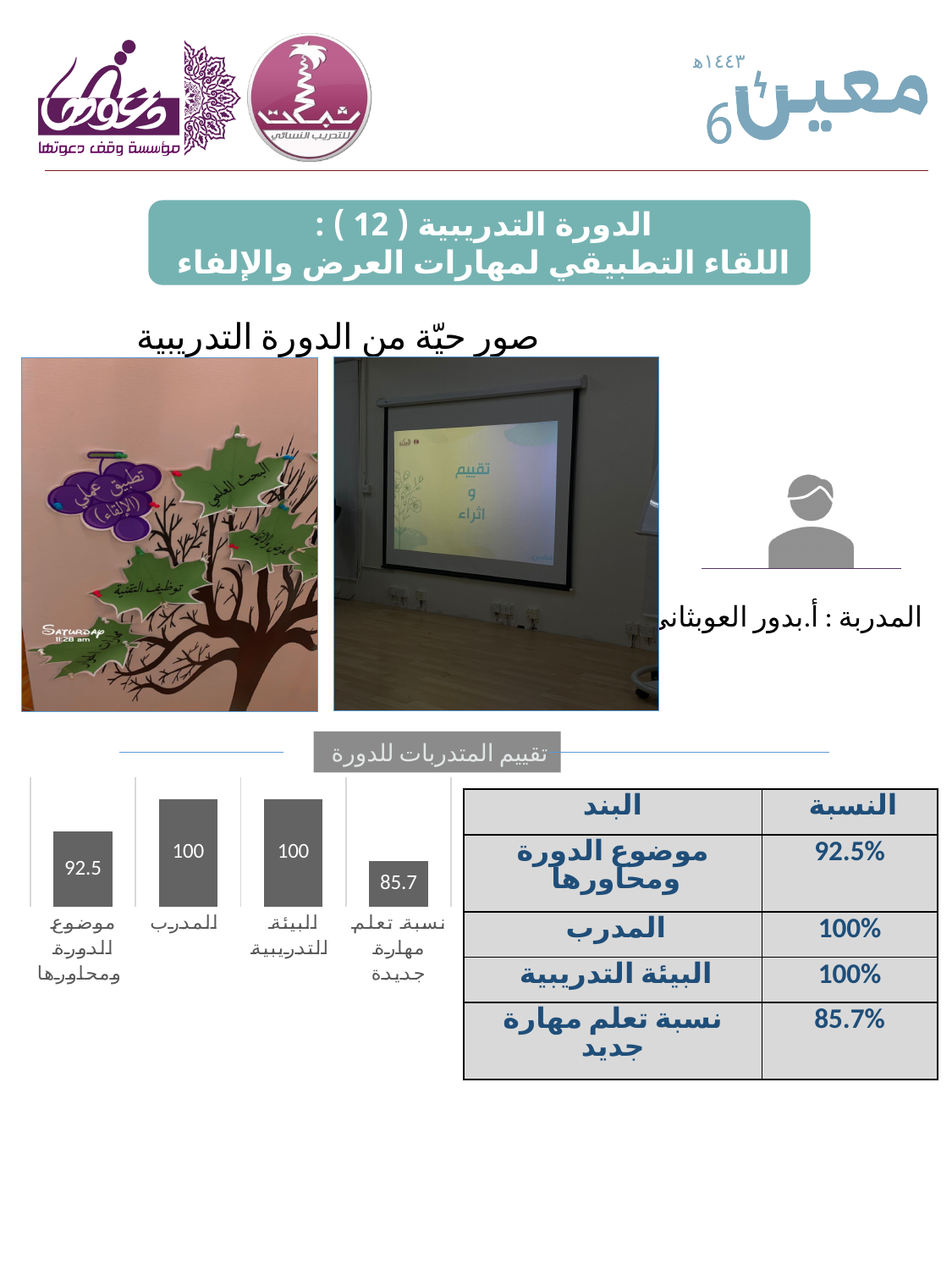
How many categories does the bar chart show? 4 What is the difference between the value for موضوع الدورة ومحاورها and the value for نسبة تعلم مهارة جديدة in the bar chart? 6.8 What is the value for نسبة تعلم مهارة جديدة in the bar chart? 85.7 What is the difference between the value for المدرب and the value for نسبة تعلم مهارة جديدة in the bar chart? 14.3 What is the value for موضوع الدورة ومحاورها in the bar chart? 92.5 What is the value for المدرب in the bar chart? 100 Which is larger in the bar chart: the value for البيئة التدريبية or the value for موضوع الدورة ومحاورها? البيئة التدريبية What is the value for البيئة التدريبية in the bar chart? 100 What is the title shown above the bar chart? تقييم المتدربات للدورة Which category has the lowest value in the bar chart? نسبة تعلم مهارة جديدة What type of chart is shown under the heading تقييم المتدربات للدورة? bar chart Which is larger in the bar chart: the value for موضوع الدورة ومحاورها or the value for نسبة تعلم مهارة جديدة? موضوع الدورة ومحاورها